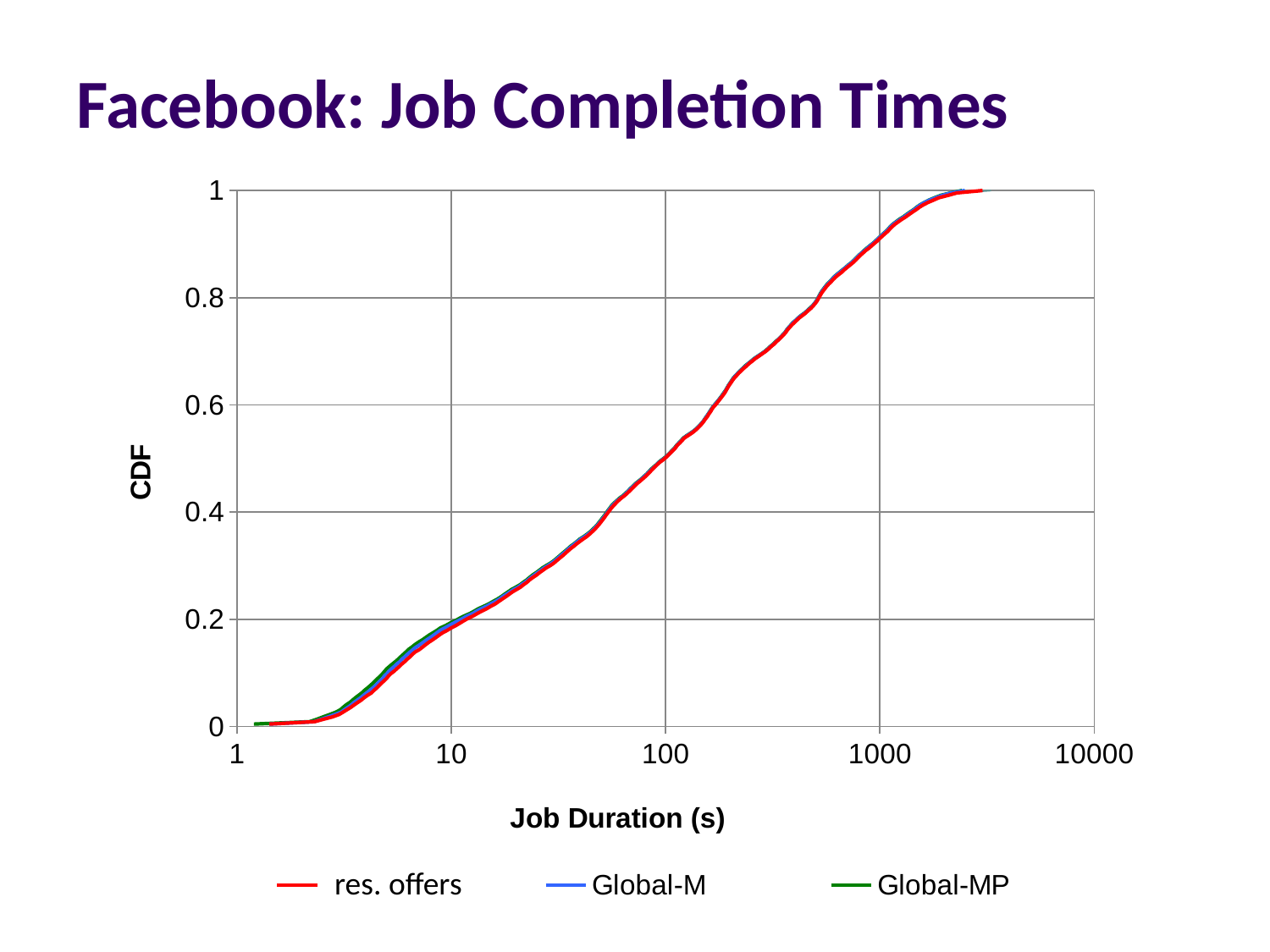
What is the label of the x axis? Job Duration (s) Do the CDF values rise or fall as job duration increases along the x axis? rise What is the title of the chart on the slide? Facebook: Job Completion Times Is the CDF value for Global-M at a job duration of 1000 s greater or less than 0.8? greater What is the maximum value shown on the y axis (CDF)? 1 What kind of chart is shown on the slide? line chart How many series does the legend list? 3 What is the largest tick value shown on the x axis? 10000 Is the CDF value for Global-MP at a job duration of 10 s greater or less than 0.4? less Is the CDF value for res. offers at a job duration of 100 s greater or less than 0.6? less